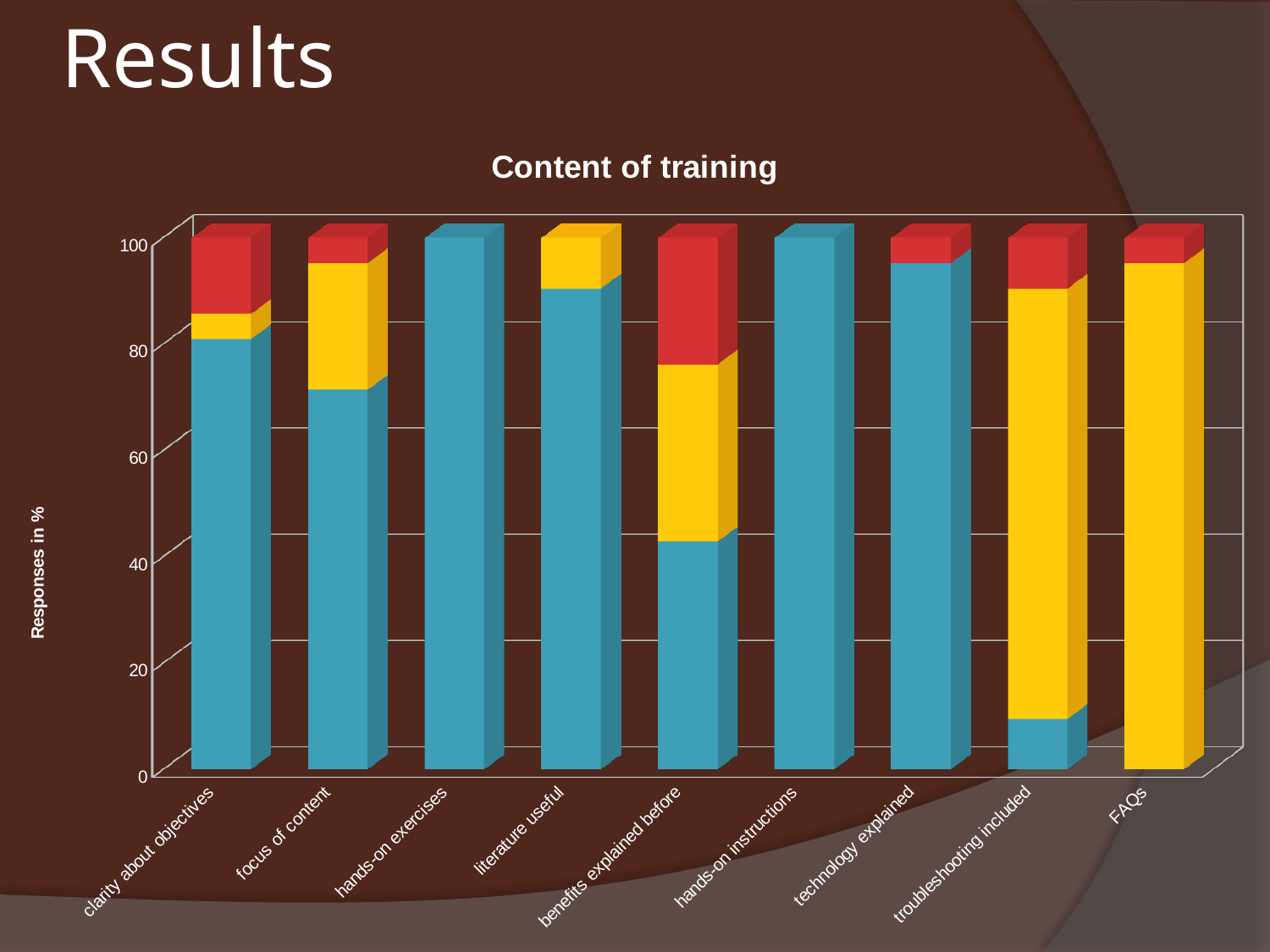
What kind of chart is shown on the slide? Stacked bar chart Is the blue segment for 'troubleshooting included' greater or less than 20? less Is the blue segment for 'literature useful' greater or less than 80? greater Which category has the largest red segment? benefits explained before What is the title of the chart? Content of training What is the label on the vertical axis of the chart? Responses in % What is the total height of the stacked bar for 'hands-on exercises'? 100 Is the blue segment for 'benefits explained before' greater or less than 60? less How many categories are shown along the horizontal axis of the chart? 9 Which category has the largest yellow segment? FAQs Which has the larger blue segment, 'focus of content' or 'benefits explained before'? focus of content